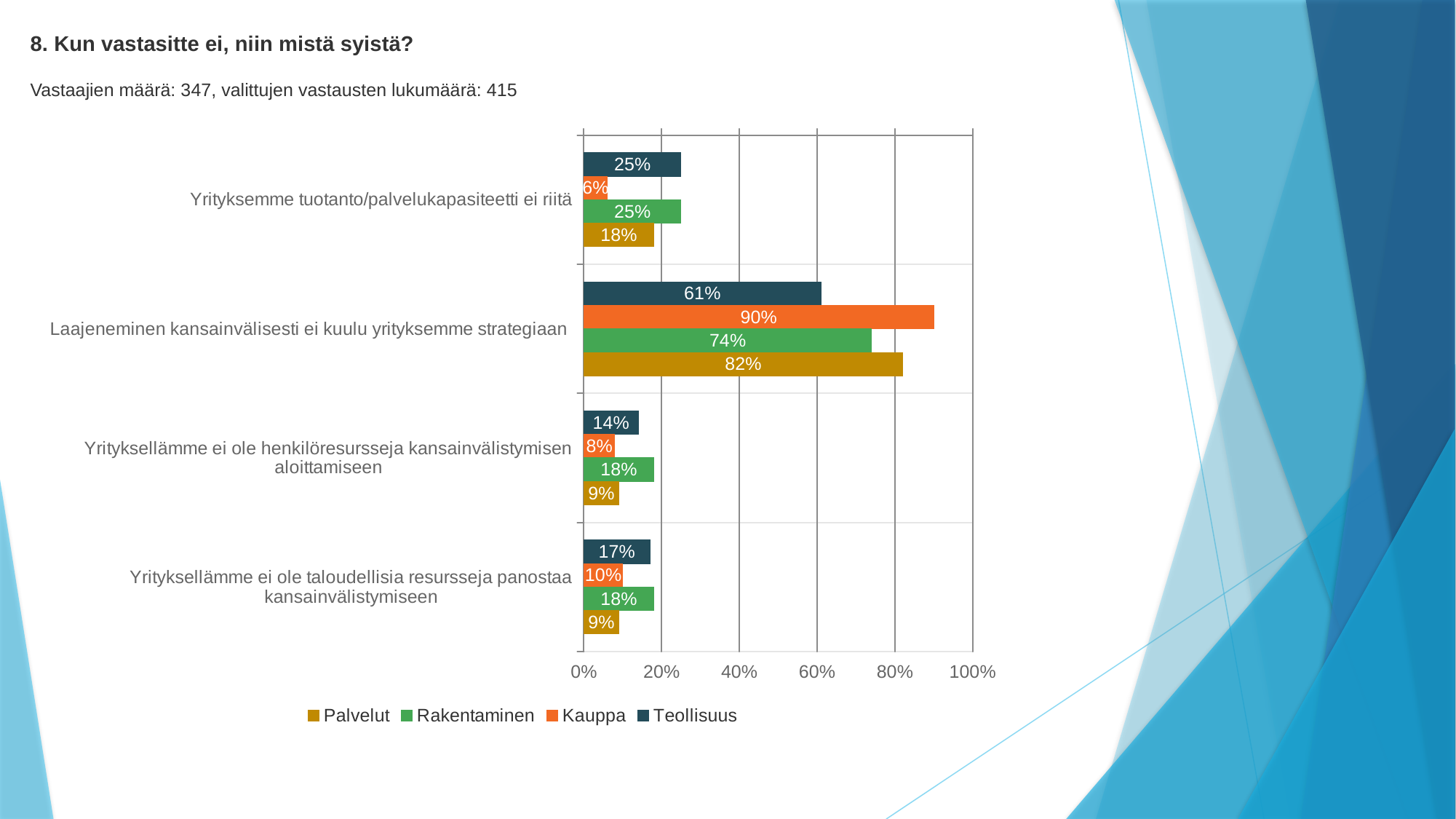
How many categories are shown on the chart? 4 Which legend entry is shown in orange? Kauppa What is the Teollisuus value for 'Yrityksellämme ei ole henkilöresursseja kansainvälistymisen aloittamiseen'? 14% What type of chart is shown on the slide? Bar chart What is the Kauppa value for 'Laajeneminen kansainvälisesti ei kuulu yrityksemme strategiaan'? 90% Is the Rakentaminen value for 'Laajeneminen kansainvälisesti ei kuulu yrityksemme strategiaan' greater or less than 60%? greater Which series has the highest value for 'Laajeneminen kansainvälisesti ei kuulu yrityksemme strategiaan'? Kauppa Which is larger for 'Yrityksellämme ei ole taloudellisia resursseja panostaa kansainvälistymiseen': the Rakentaminen value or the Kauppa value? Rakentaminen What is the difference between the Palvelut and Teollisuus values for 'Laajeneminen kansainvälisesti ei kuulu yrityksemme strategiaan'? 21% Which series has the lowest value for 'Yrityksemme tuotanto/palvelukapasiteetti ei riitä'? Kauppa How many series does the legend list? 4 What is the Palvelut value for 'Yrityksemme tuotanto/palvelukapasiteetti ei riitä'? 18%